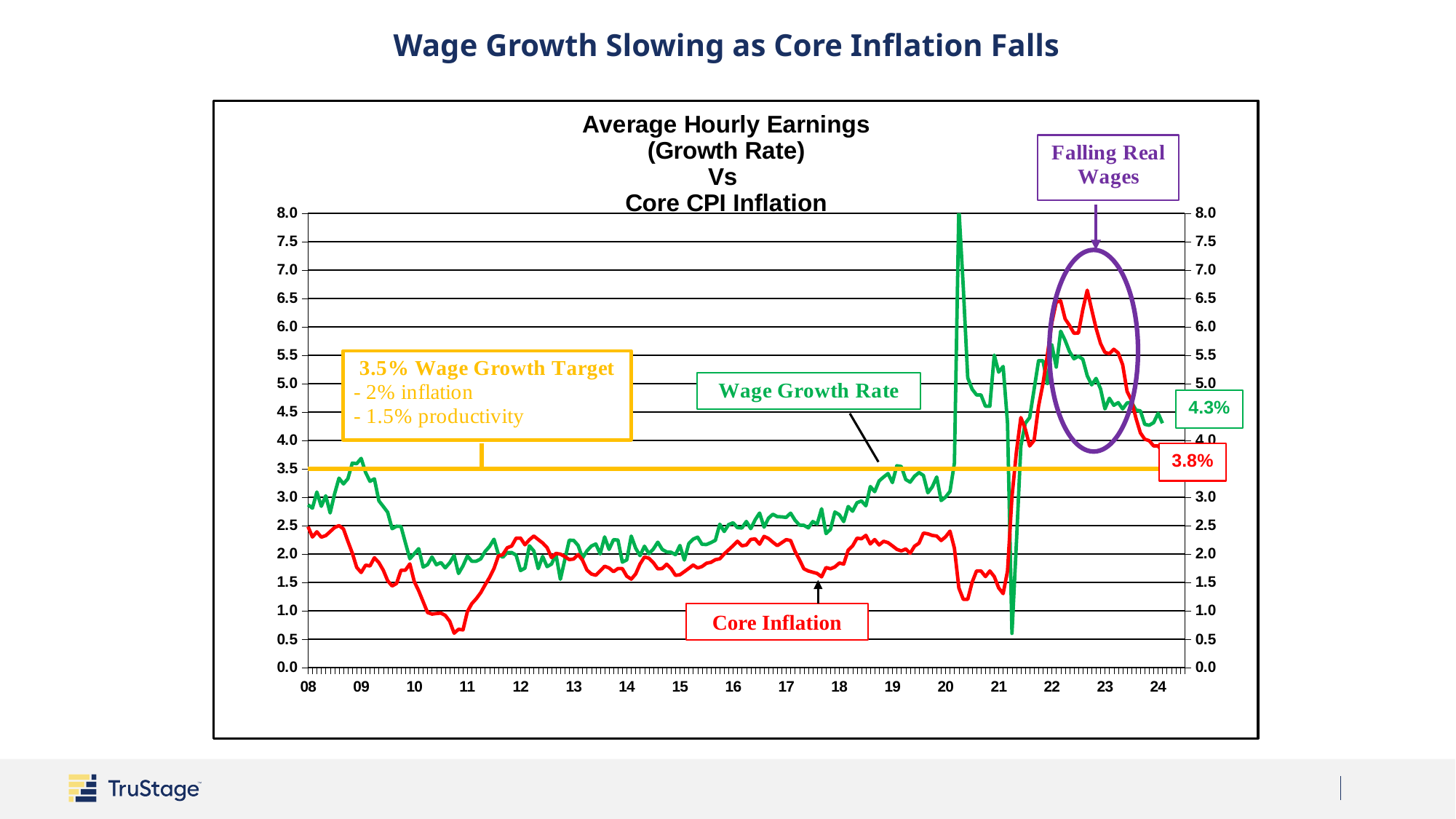
What is the most recent value labelled for the Wage Growth Rate series? 4.3% What kind of chart is shown on the slide? line chart Is Core Inflation at the 11 tick greater or less than 1.5? less What does the purple oval on the chart highlight, according to its label? Falling Real Wages Is the Wage Growth Rate at the 09 tick greater or less than 3.0? greater What is the most recent value labelled for the Core Inflation series? 3.8% How many data series are plotted on the chart? 3 Which series reaches the highest peak on the chart? Wage Growth Rate Does Core Inflation rise or fall between its 2022 peak and the end of the chart in 2024? fall At what level is the horizontal Wage Growth Target line drawn? 3.5% At the end of the chart, which is larger: the labelled Wage Growth Rate or the labelled Core Inflation? Wage Growth Rate What is the difference between the latest labelled Wage Growth Rate (4.3%) and the latest labelled Core Inflation (3.8%)? 0.5%